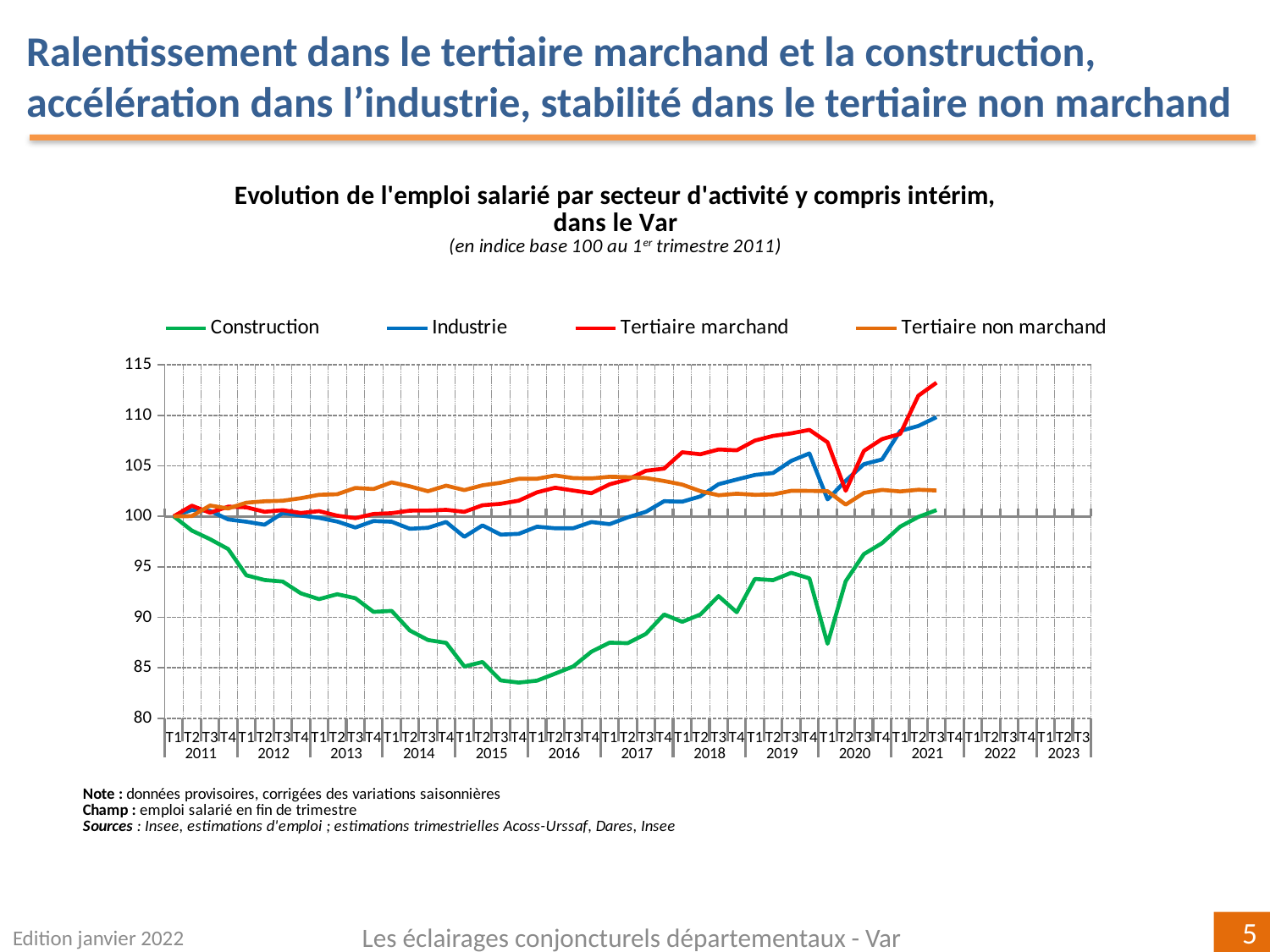
What is the base value of the index used in the chart, and at which quarter? 100 au 1er trimestre 2011 Is the value for Construction at T2 2020 greater or less than 90? greater How many series does the legend list? 4 Is the value for Tertiaire non marchand at T3 2021 greater or less than 105? less Which series has the highest value at the last plotted quarter (T3 2021)? Tertiaire marchand At T3 2021, which is larger: Industrie or Tertiaire non marchand? Industrie Is the value for Tertiaire marchand at T3 2021 greater or less than 110? greater Which series are listed in the legend? Construction, Industrie, Tertiaire marchand, Tertiaire non marchand What kind of chart is shown on the slide? line chart Which series has the lowest value at the last plotted quarter (T3 2021)? Construction Does the Construction series rise or fall between T1 2011 and T1 2016? fall